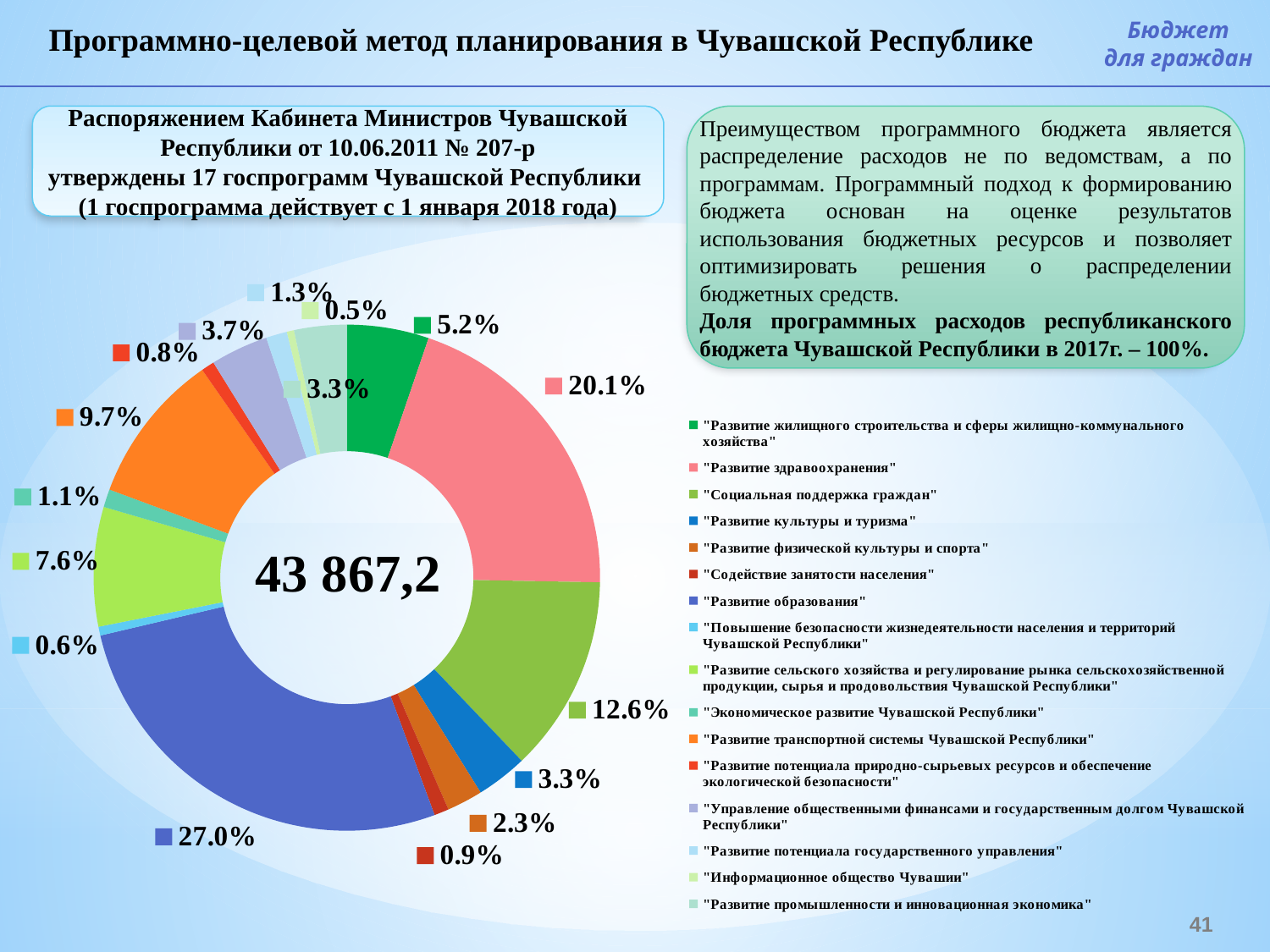
What share of the chart does "Развитие здравоохранения" have? 20.1% What share of the chart does "Социальная поддержка граждан" have? 12.6% What share of the chart does "Развитие образования" have? 27.0% What is the difference in percentage points between the shares of "Развитие образования" and "Развитие здравоохранения"? 6.9 What is the value shown in the centre of the doughnut chart? 43 867,2 Which program has the largest share of the chart? "Развитие образования" Which program has the smallest share of the chart? "Информационное общество Чувашии" What kind of chart is shown on the slide? doughnut chart How many entries does the legend list? 16 Which has a larger share: "Развитие здравоохранения" or "Социальная поддержка граждан"? "Развитие здравоохранения" What share of the chart does "Развитие транспортной системы Чувашской Республики" have? 9.7% How many slices does the chart have? 16